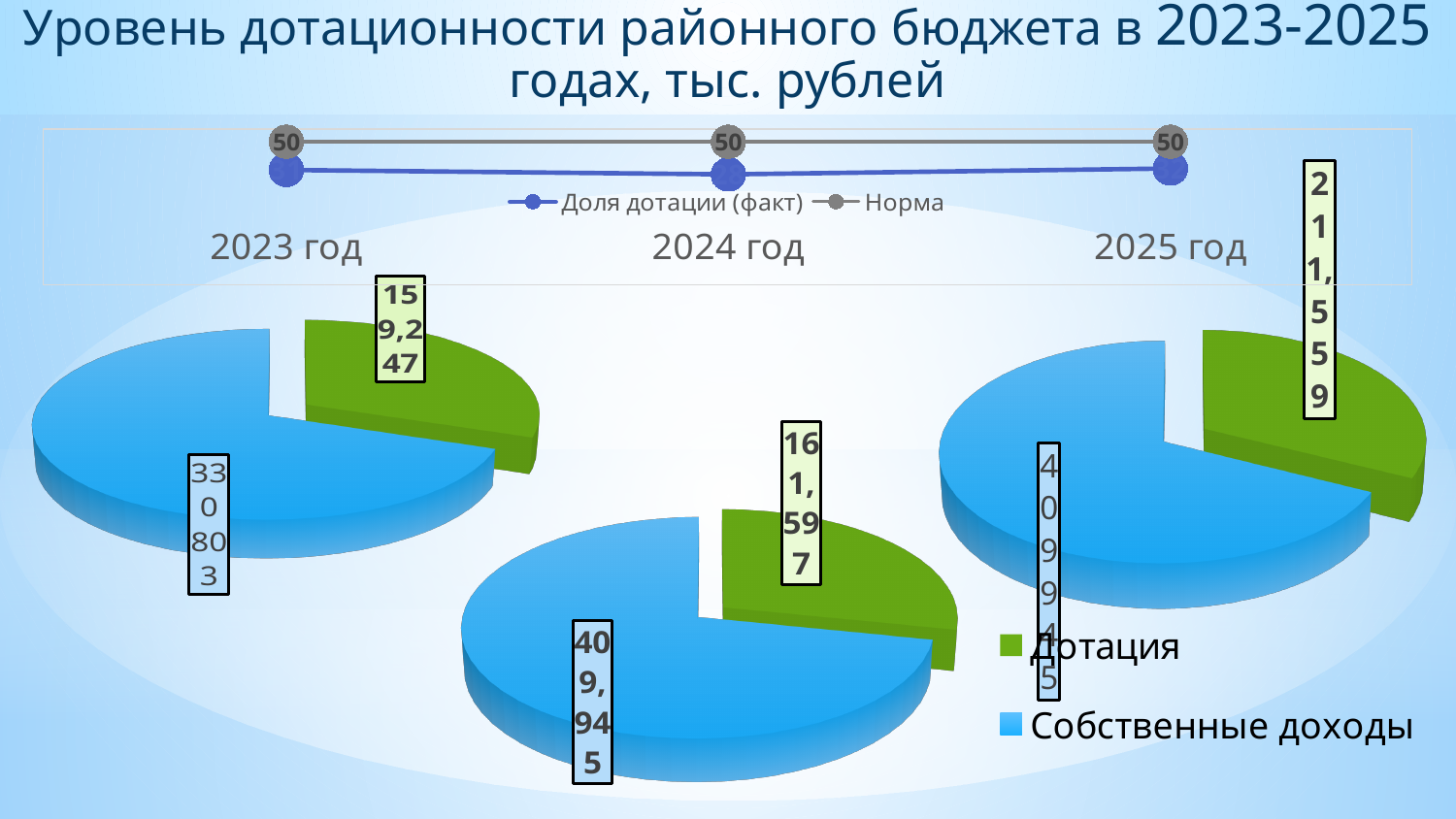
How many years are shown on the x axis of the top line chart? 3 What kind of chart is the top chart showing Доля дотации (факт) and Норма? line chart How many series does the legend of the top line chart list? 2 What colour represents Дотация in the pie charts' legend? green In the 2023 год pie chart, which is larger: Дотация or Собственные доходы? Собственные доходы In the top line chart, is the value of Доля дотации (факт) for 2025 год greater or less than 50? less In the 2024 год pie chart, what is the value for Дотация? 161,597 In the 2023 год pie chart, what is the value for Дотация? 159,247 Across the three pie charts, which year has the highest value for Дотация? 2025 год In the 2025 год pie chart, what is the value for Дотация? 211,559 In the top line chart, what is the value of Норма for 2024 год? 50 In the top line chart, which is larger for 2023 год: Доля дотации (факт) or Норма? Норма